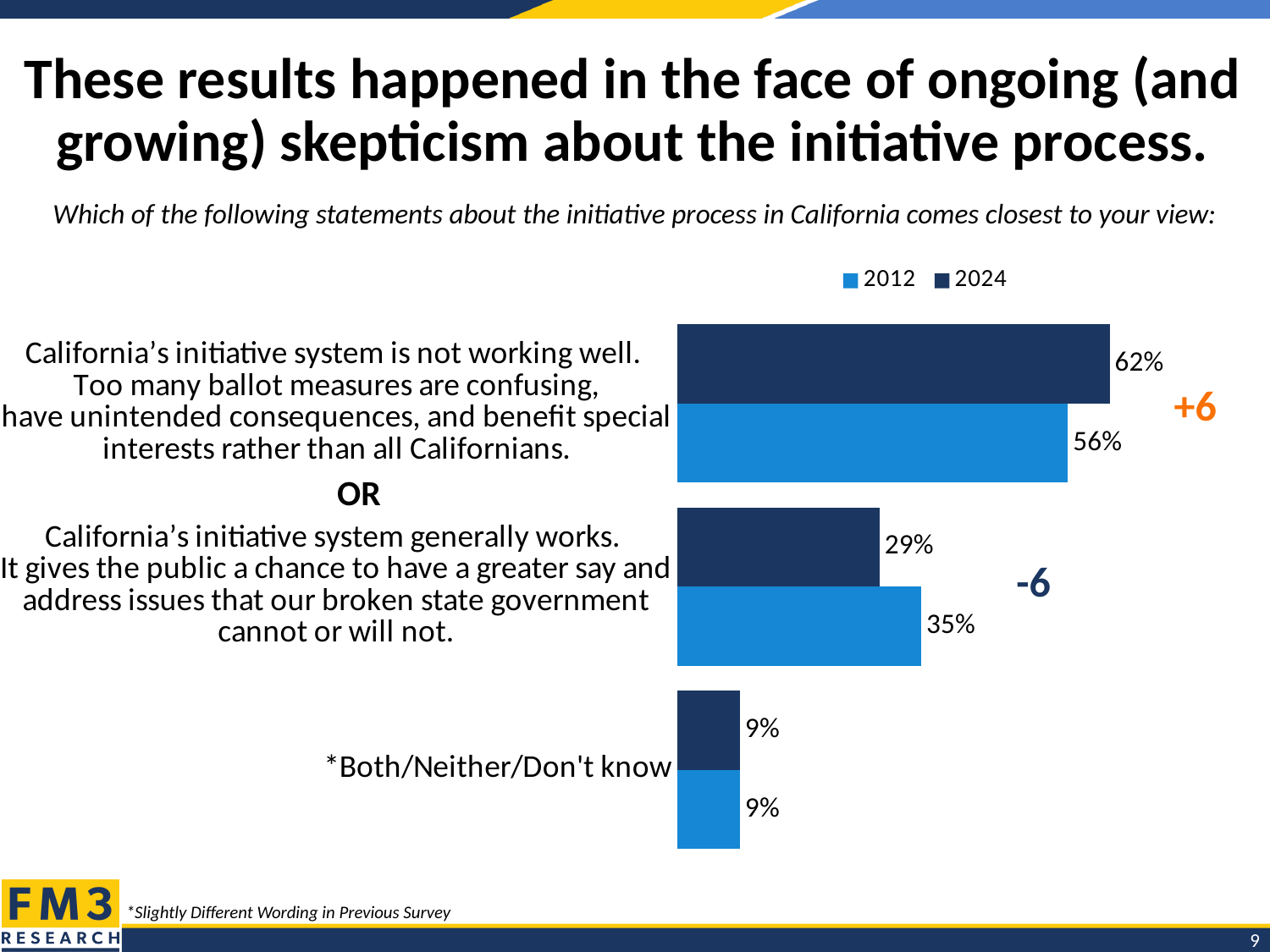
By how many percentage points did the share saying the initiative system is not working well change from 2012 to 2024? 6 percentage points (56% to 62%) What percentage of respondents in 2012 said California's initiative system generally works? 35% Which colour represents the 2024 series in the chart? Dark blue What percentage of respondents in 2012 said California's initiative system is not working well? 56% Which response category has the lowest value for 2012? Both/Neither/Don't know How many series does the legend list? 2 What kind of chart is shown on the slide? Bar chart What percentage of respondents in 2024 said California's initiative system is not working well? 62% What percentage of respondents in 2024 said California's initiative system generally works? 29% Which year had a larger share saying the initiative system generally works, 2012 or 2024? 2012 What percentage of respondents answered Both/Neither/Don't know in 2024? 9% Which response category has the highest value for 2024? California's initiative system is not working well